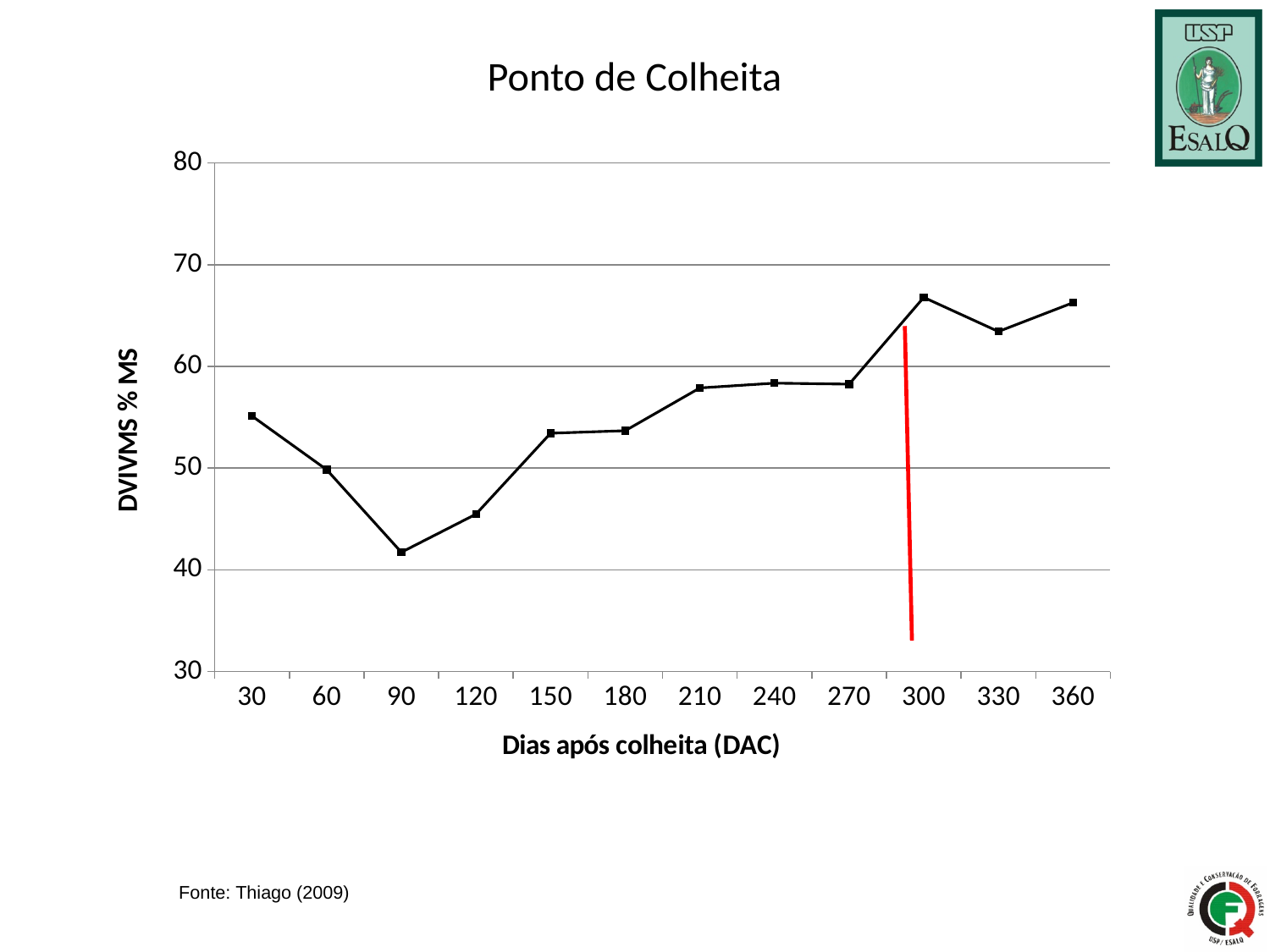
How many data points are plotted on the line? 12 What is the title of the x axis? Dias após colheita (DAC) At which value of Dias após colheita (DAC) is DVIVMS % MS lowest? 90 What kind of chart is shown on the slide? line chart Which has the higher DVIVMS % MS, 150 DAC or 300 DAC? 300 Do the values rise or fall between 90 DAC and 300 DAC? rise Is the value for 300 DAC greater or less than 60? greater Is the value for 210 DAC greater or less than 60? less Which has the higher DVIVMS % MS, 30 DAC or 90 DAC? 30 Is the value for 90 DAC greater or less than 50? less